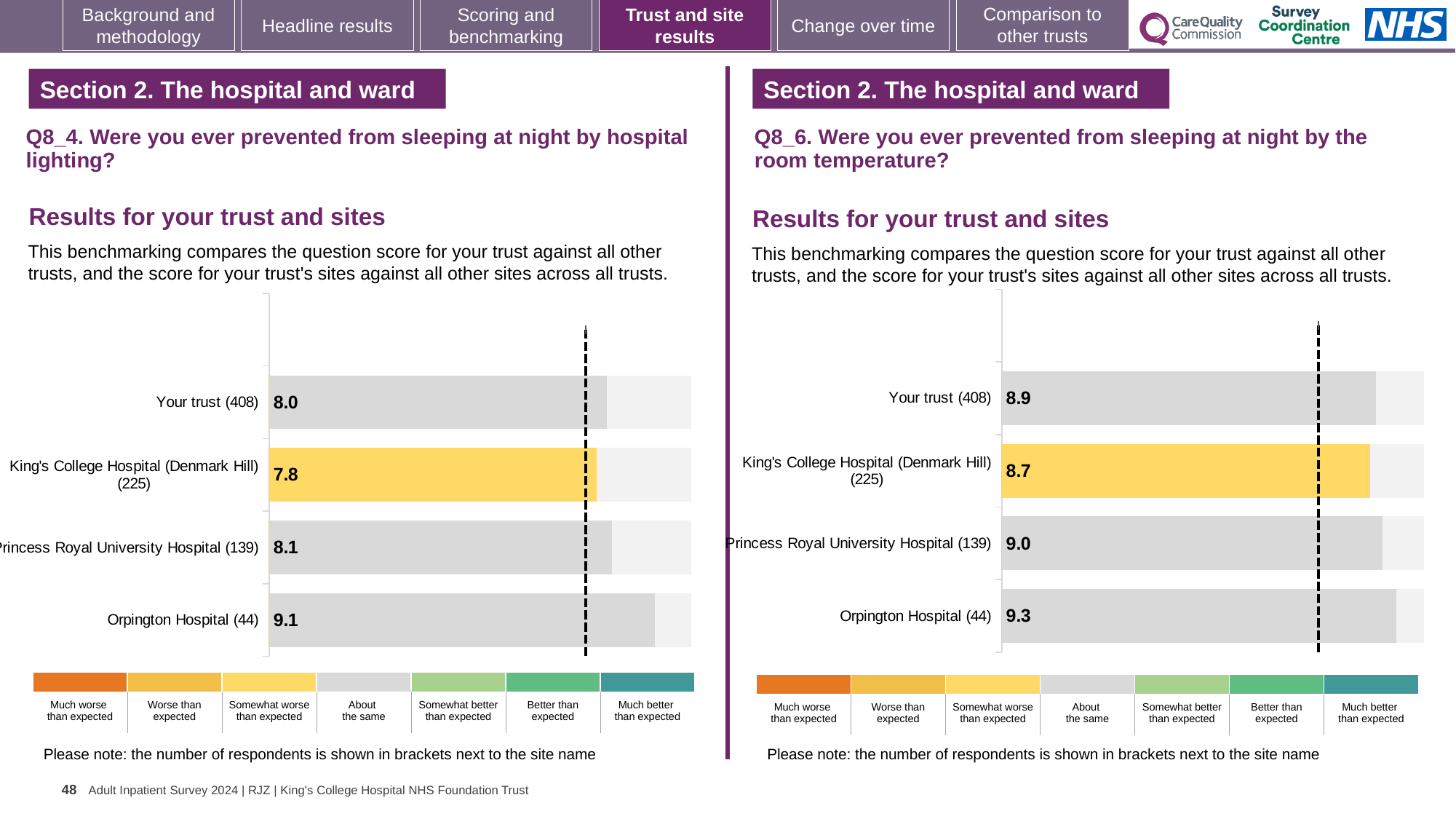
What type of chart is used in the Q8_6 chart (room temperature)? Bar chart In the Q8_6 chart (room temperature), which bar has the lowest score? King's College Hospital (Denmark Hill) (225) In the Q8_6 chart (room temperature), what is the score for Orpington Hospital (44)? 9.3 In the Q8_4 chart (hospital lighting), what is the score for Your trust (408)? 8.0 In the Q8_4 chart (hospital lighting), which site has the highest score? Orpington Hospital (44) In the Q8_6 chart (room temperature), what is the difference between the scores for Orpington Hospital (44) and Your trust (408)? 0.4 In the Q8_6 chart (room temperature), which is larger: the score for Your trust (408) or for King's College Hospital (Denmark Hill) (225)? Your trust (408) How many bars are shown in the Q8_4 chart (hospital lighting)? 4 In the Q8_4 chart (hospital lighting), which bar has the lowest score? King's College Hospital (Denmark Hill) (225) In the Q8_4 chart (hospital lighting), what is the difference between the scores for Orpington Hospital (44) and Princess Royal University Hospital (139)? 1.0 In the Q8_4 chart (hospital lighting), what is the score for King's College Hospital (Denmark Hill) (225)? 7.8 In the Q8_6 chart (room temperature), what is the score for Princess Royal University Hospital (139)? 9.0